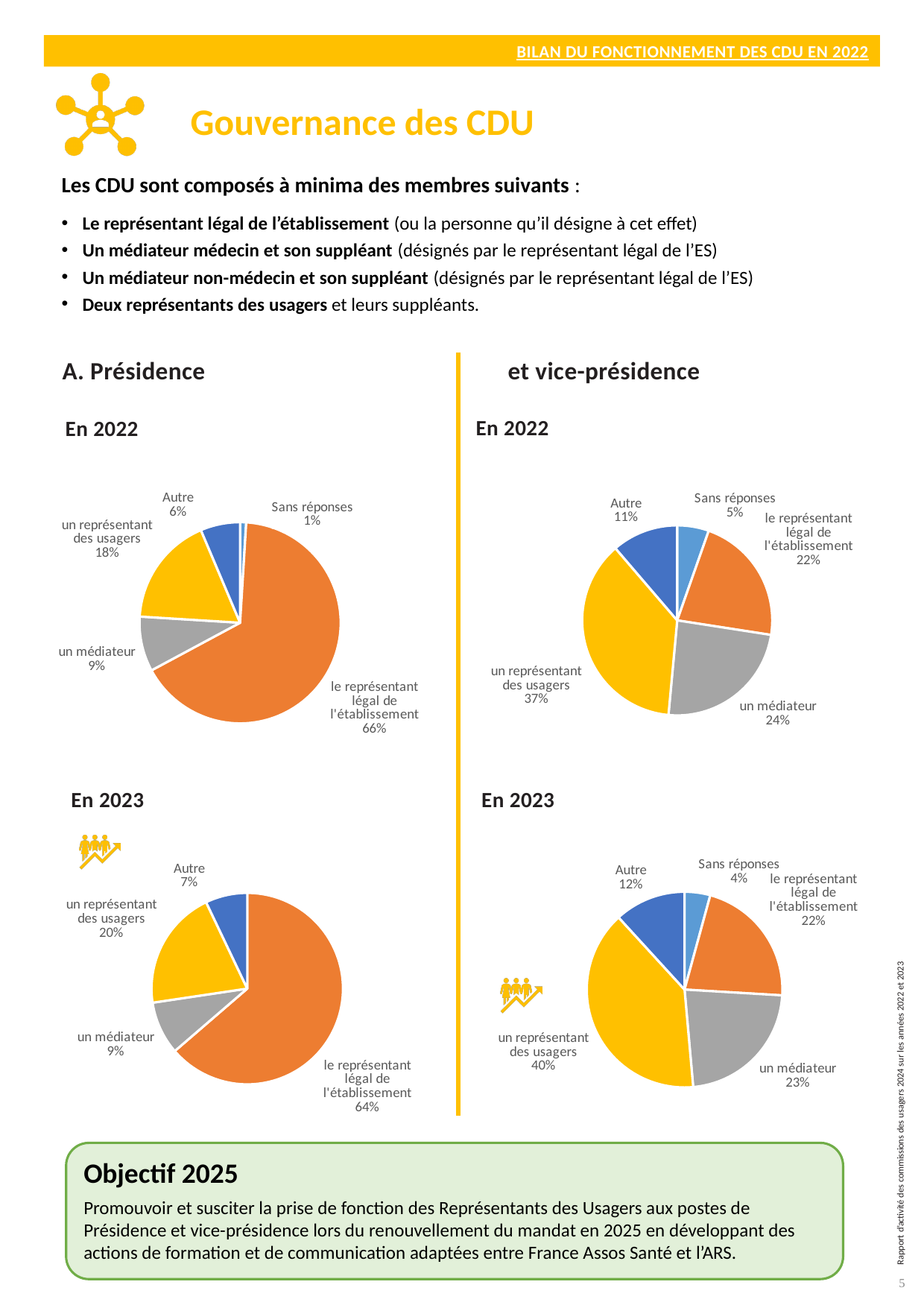
How many slices does the Présidence En 2023 pie chart have? 4 In the Présidence En 2022 pie chart, which is larger: the share for 'un représentant des usagers' or the share for 'un médiateur'? un représentant des usagers How many pie charts are shown on the slide? 4 In the Présidence En 2022 pie chart, which category has the smallest share? Sans réponses In the vice-présidence En 2023 pie chart, what share is labelled for 'Sans réponses'? 4% In the vice-présidence En 2023 pie chart, what is the difference between the shares of 'un représentant des usagers' and 'un médiateur'? 17 percentage points In the vice-présidence En 2023 pie chart, what share is labelled for 'Autre'? 12% In the vice-présidence En 2022 pie chart, which category has the largest share? un représentant des usagers In the Présidence En 2022 pie chart, what share is labelled for 'le représentant légal de l'établissement'? 66% What type of chart is used for the Présidence En 2022 data? Pie chart In the vice-présidence En 2022 pie chart, what share is labelled for 'un médiateur'? 24% In the Présidence En 2023 pie chart, what share is labelled for 'un représentant des usagers'? 20%